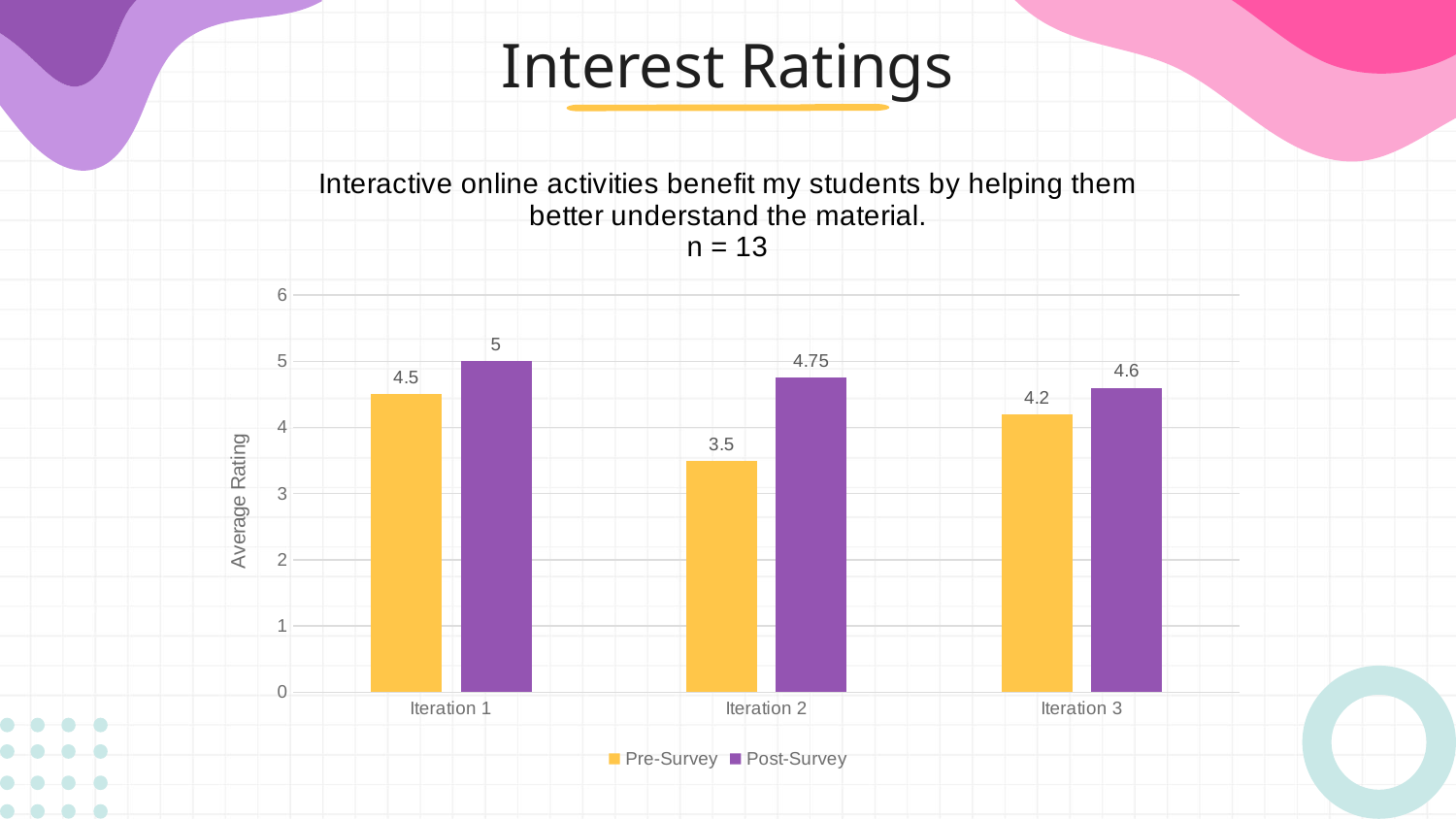
How many series does the legend list? 2 What is the Post-Survey average rating for Iteration 2? 4.75 Which iteration has the highest Post-Survey average rating? Iteration 1 What kind of chart is shown on the slide? Bar chart What is the Pre-Survey average rating for Iteration 1? 4.5 Which is larger, the Pre-Survey rating for Iteration 1 or the Post-Survey rating for Iteration 3? Post-Survey rating for Iteration 3 What is the Pre-Survey average rating for Iteration 3? 4.2 How many iterations are shown on the x axis? 3 What is the difference between the Post-Survey and Pre-Survey ratings for Iteration 3? 0.4 What is the difference between the Post-Survey and Pre-Survey ratings for Iteration 2? 1.25 Which iteration has the lowest Pre-Survey average rating? Iteration 2 What is the label of the y axis? Average Rating